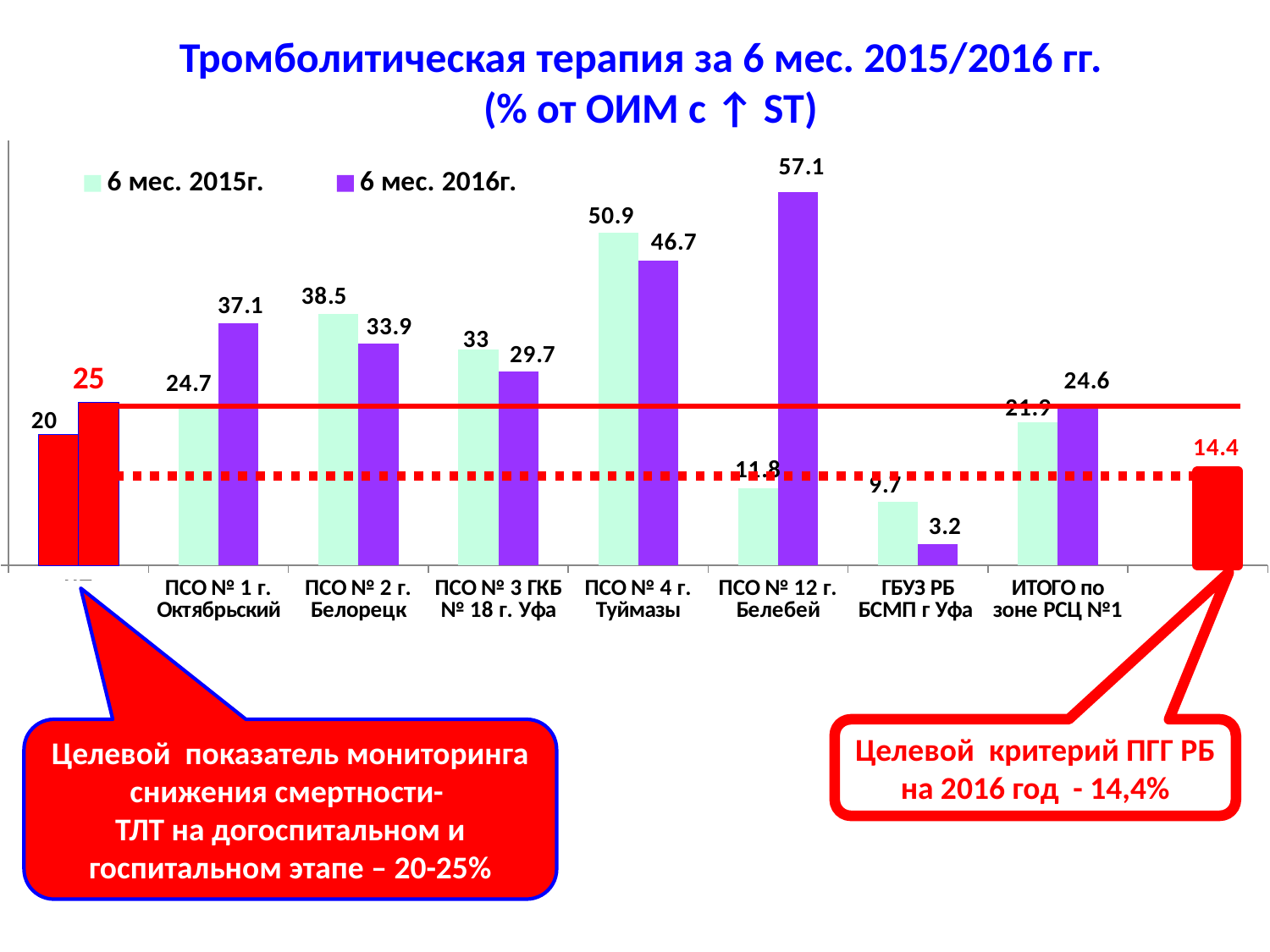
Which category has the highest value in the 6 мес. 2016г. series? ПСО № 12 г. Белебей What is the value for ПСО № 4 г. Туймазы in the 6 мес. 2015г. series? 50.9 Which category has the highest value in the 6 мес. 2015г. series? ПСО № 4 г. Туймазы What is the value for ПСО № 1 г. Октябрьский in the 6 мес. 2016г. series? 37.1 What is the value for ПСО № 12 г. Белебей in the 6 мес. 2015г. series? 11.8 What is the difference between the 6 мес. 2016г. and 6 мес. 2015г. values for ПСО № 1 г. Октябрьский? 12.4 What is the value for ИТОГО по зоне РСЦ №1 in the 6 мес. 2016г. series? 24.6 For ПСО № 2 г. Белорецк, which series has the larger value, 6 мес. 2015г. or 6 мес. 2016г.? 6 мес. 2015г. Which category has the lowest value in the 6 мес. 2016г. series? ГБУЗ РБ БСМП г Уфа How many series does the legend list? 2 By how much did the value for ПСО № 12 г. Белебей increase from 6 мес. 2015г. to 6 мес. 2016г.? 45.3 What is the value for ГБУЗ РБ БСМП г Уфа in the 6 мес. 2016г. series? 3.2